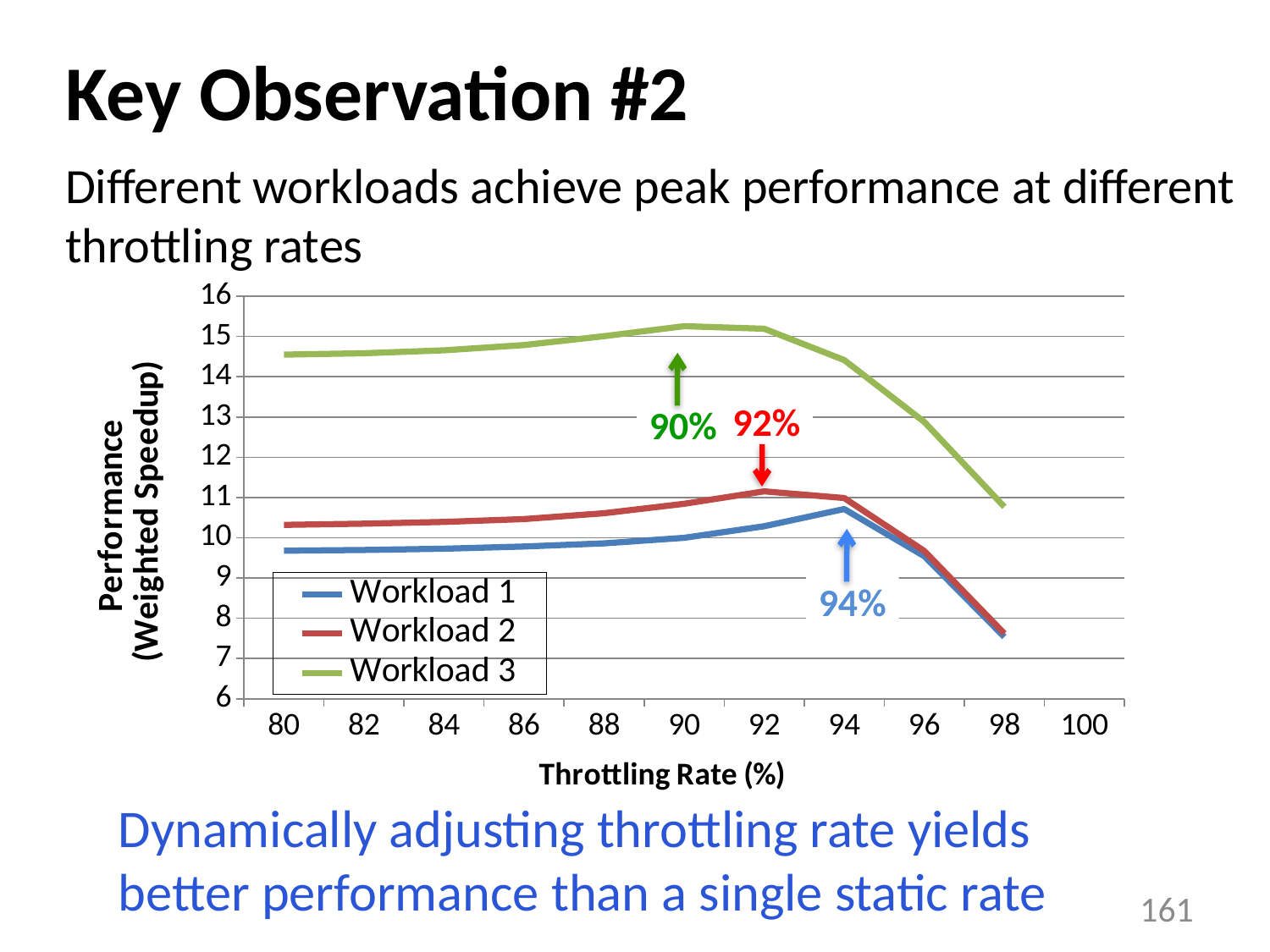
Is the value for Workload 3 at a throttling rate of 90 greater or less than 15? greater According to the annotation on the chart, at what throttling rate does Workload 1 reach its peak performance? 94% Is the value for Workload 1 at a throttling rate of 80 greater or less than 10? less What is the title of the x axis? Throttling Rate (%) Which workload has the highest performance across the plotted throttling rates? Workload 3 According to the annotation on the chart, at what throttling rate does Workload 3 reach its peak performance? 90% How many series does the legend list? 3 What are the series names listed in the legend? Workload 1, Workload 2, Workload 3 Which workload has the lowest performance at a throttling rate of 80? Workload 1 What kind of chart is shown on the slide? line chart Is the value for Workload 2 at a throttling rate of 98 greater or less than 8? less At a throttling rate of 90, which is larger: the value for Workload 2 or the value for Workload 1? Workload 2